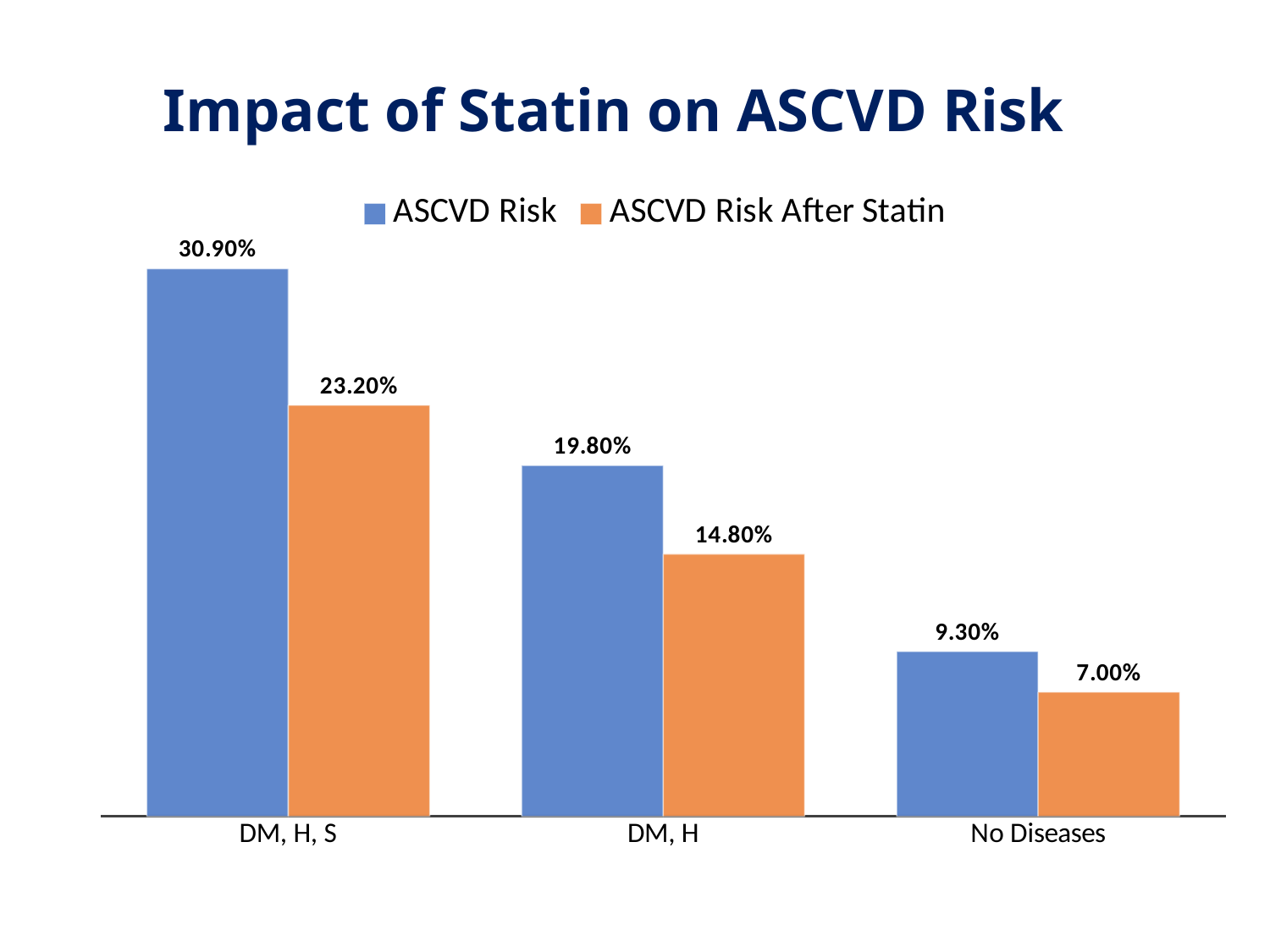
What is the difference between ASCVD Risk and ASCVD Risk After Statin for the DM, H, S category? 7.70% What is the title of the chart? Impact of Statin on ASCVD Risk Which is larger: the ASCVD Risk After Statin value for DM, H, S or the ASCVD Risk value for DM, H? ASCVD Risk After Statin for DM, H, S What kind of chart is shown on the slide? Bar chart Which category has the lowest ASCVD Risk After Statin value? No Diseases What is the ASCVD Risk After Statin value for the DM, H category? 14.80% How many series does the legend list? 2 What is the ASCVD Risk After Statin value for the No Diseases category? 7.00% How many categories are shown on the x axis? 3 What is the difference between the ASCVD Risk values for DM, H and No Diseases? 10.50% What is the ASCVD Risk value for the DM, H, S category? 30.90% Which category has the highest ASCVD Risk value? DM, H, S